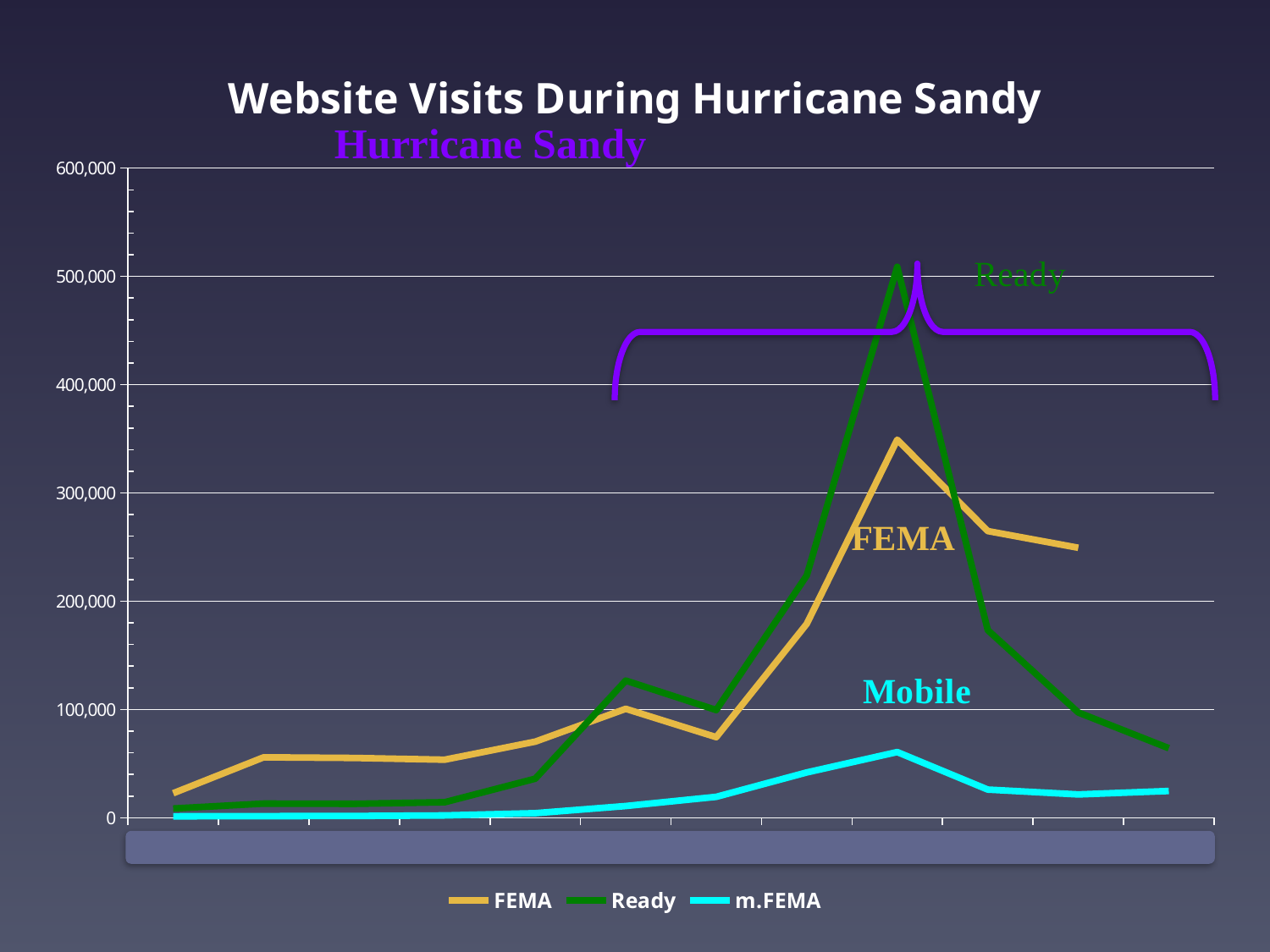
Which series are listed in the legend? FEMA, Ready, m.FEMA How many series does the legend list? 3 Is the peak value of the FEMA series greater or less than 300,000? greater Is the peak value of the Ready series greater or less than 400,000? greater Is the peak value of the m.FEMA series greater or less than 100,000? less What is the overall trend of the FEMA series along the x axis? Rises to a peak, then falls At their peaks, which series is larger, Ready or FEMA? Ready What is the title of the chart? Website Visits During Hurricane Sandy Which series reaches the highest peak value? Ready What kind of chart is shown on the slide? Line chart Which series has the lowest values across the whole chart? m.FEMA